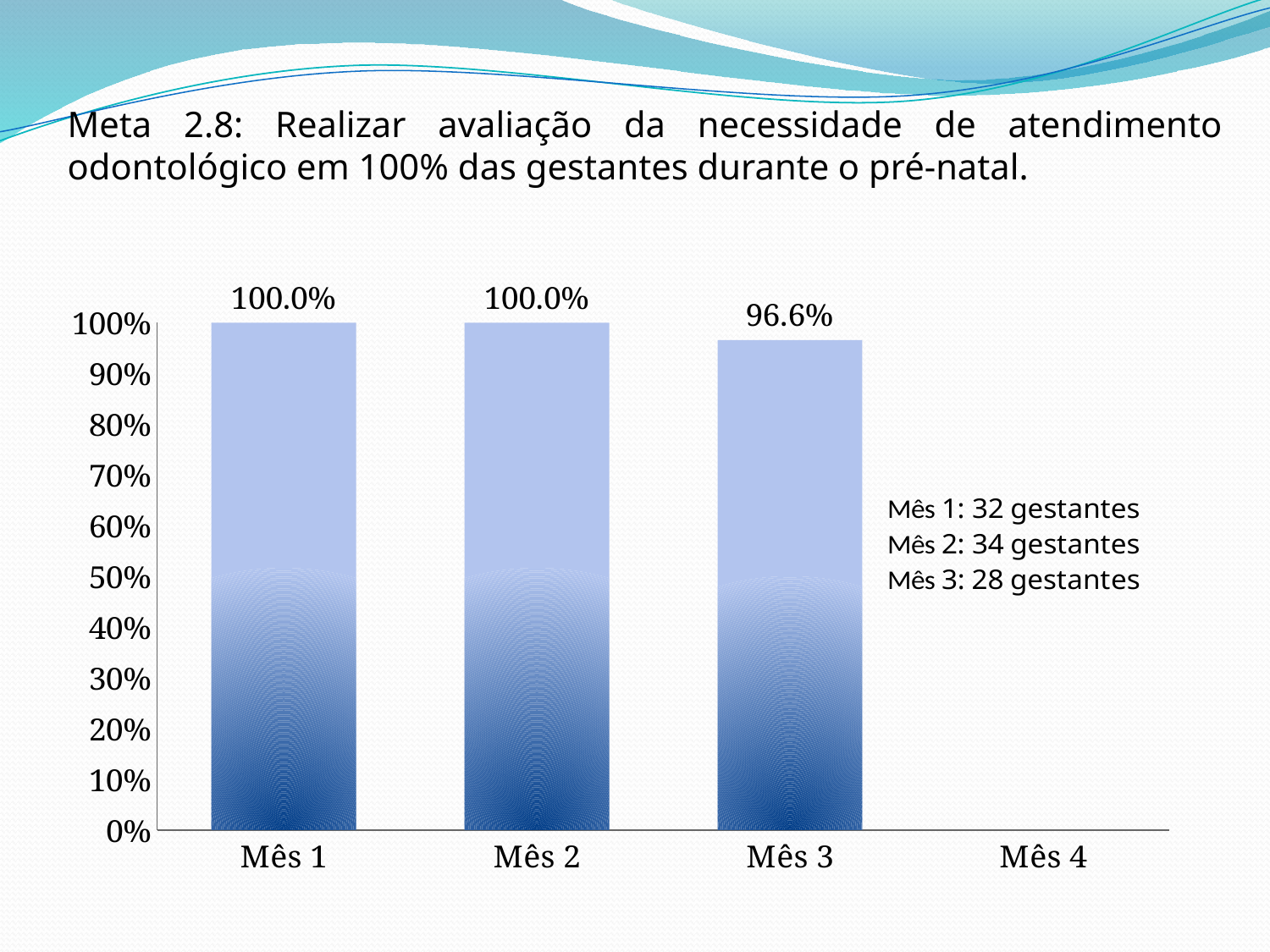
Which month has the lowest value among the bars shown with data labels? Mês 3 Do the values rise or fall from Mês 2 to Mês 3? fall According to the text next to the chart, how many gestantes were there in Mês 2? 34 gestantes What is the value for Mês 1? 100.0% What is the value for Mês 2? 100.0% Which is larger, the value for Mês 2 or the value for Mês 3? Mês 2 Is the value for Mês 3 greater or less than 90%? greater How many categories are shown on the x axis? 4 How many bars have data labels on the chart? 3 What kind of chart is shown on the slide? bar chart What is the difference between the values for Mês 1 and Mês 3? 3.4% What is the value for Mês 3? 96.6%